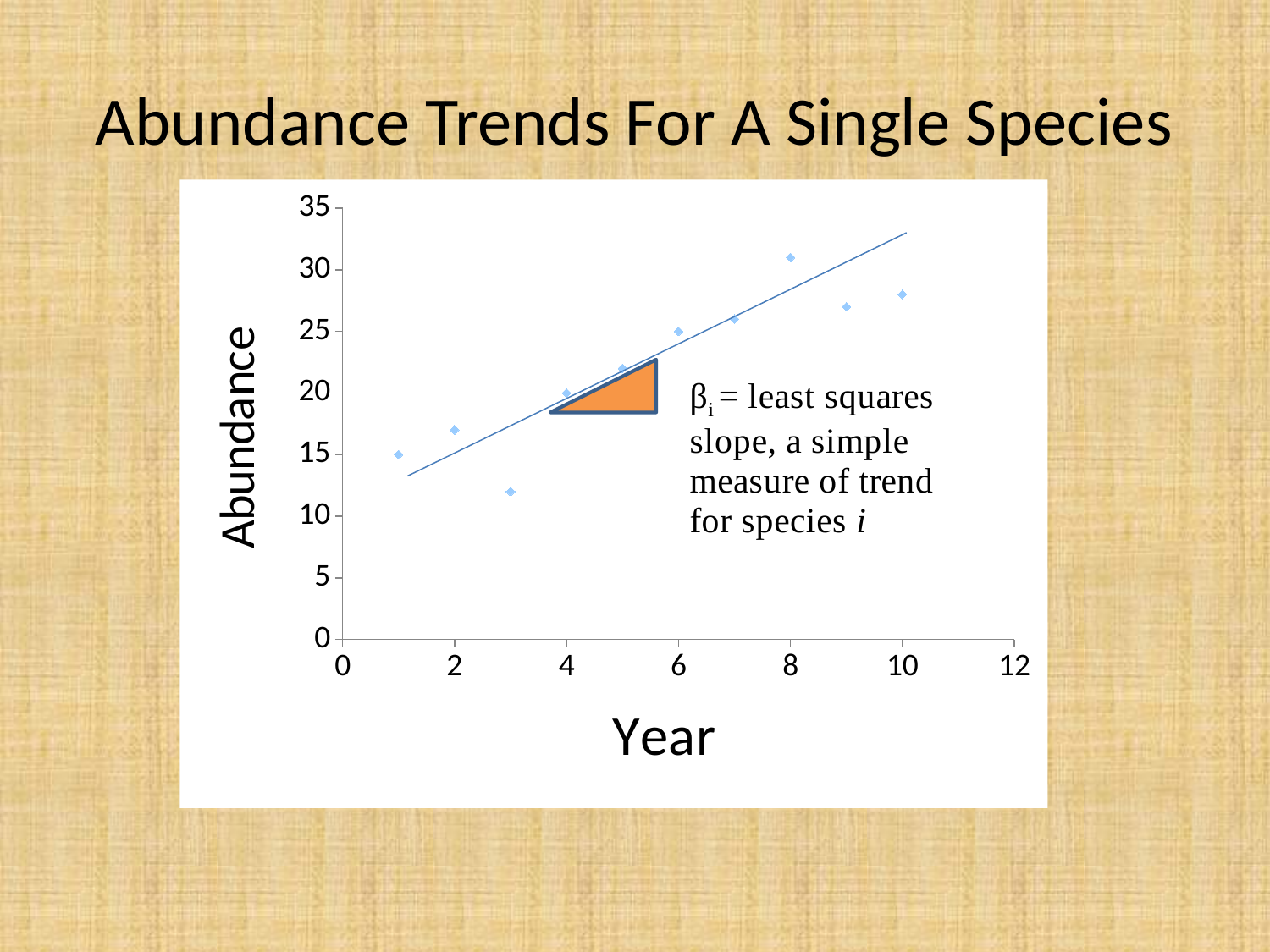
In which year is abundance lowest? 3 Do the abundance values generally rise or fall as year increases? Rise What is the abundance value in year 1? 15 What is the title of the chart's vertical axis? Abundance What is the abundance value in year 4? 20 How many data points are plotted on the chart? 10 What is the title of the chart's horizontal axis? Year In which year is abundance highest? 8 Which year has the larger abundance, year 2 or year 7? 7 Is the abundance value in year 3 greater or less than 15? less What kind of chart is shown on the slide? Scatter plot Is the abundance value in year 8 greater or less than 30? greater